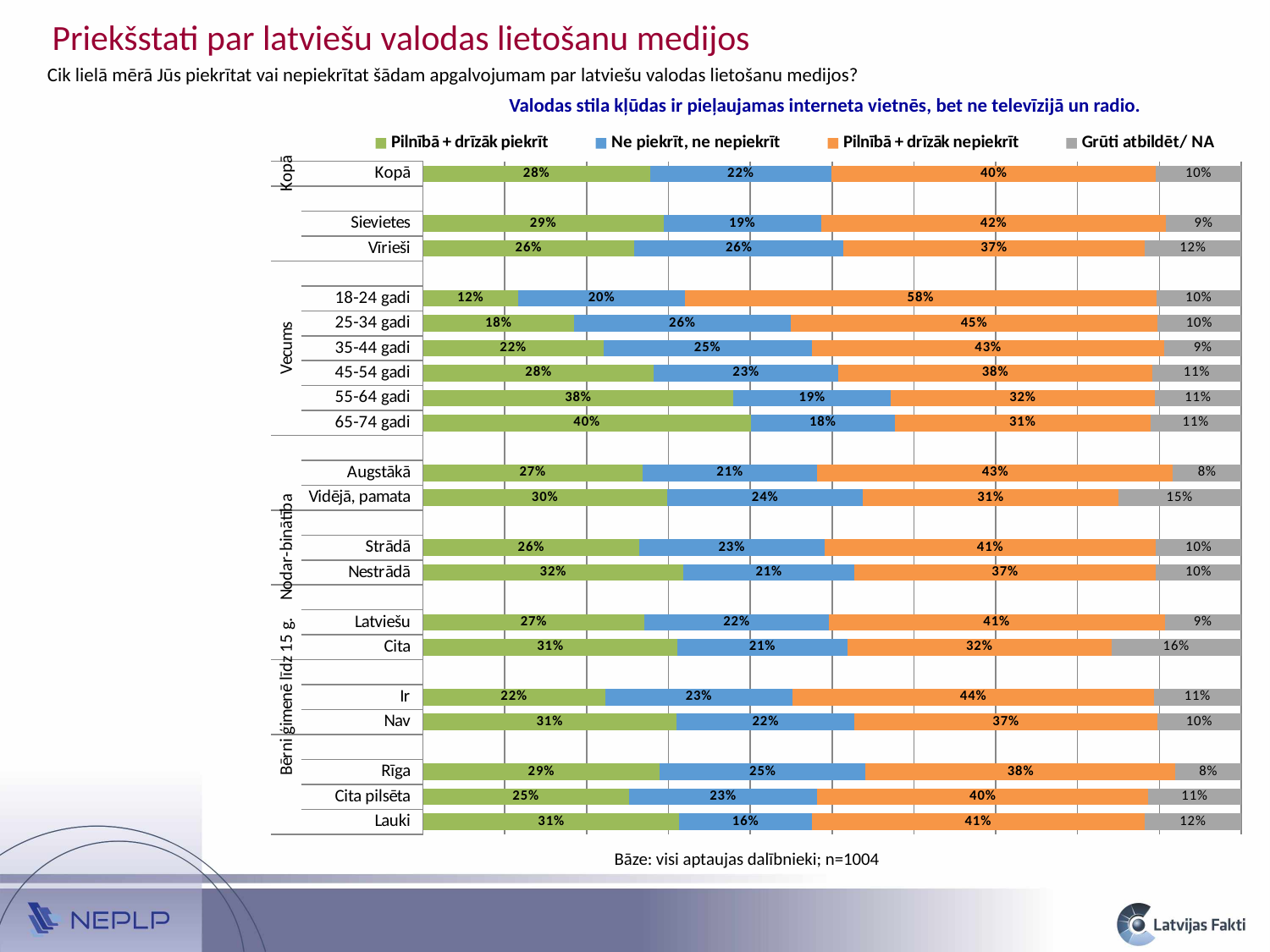
What is the value of 'Grūti atbildēt/ NA' for Vidējā, pamata? 15% Which is larger: the 'Ne piekrīt, ne nepiekrīt' value for Rīga or for Lauki? Rīga What is the value of 'Pilnībā + drīzāk piekrīt' for Kopā? 28% What type of chart is shown on the slide? Stacked bar chart Which category has the highest value for 'Pilnībā + drīzāk piekrīt'? 65-74 gadi Which category has the highest value for 'Grūti atbildēt/ NA'? Cita What is the difference between the 'Pilnībā + drīzāk nepiekrīt' values for Sievietes and Vīrieši? 5% What is the value of 'Ne piekrīt, ne nepiekrīt' for Vīrieši? 26% Which category has the lowest value for 'Pilnībā + drīzāk piekrīt'? 18-24 gadi How many categories (bars) are plotted in the chart? 20 How many series does the legend list? 4 What is the value of 'Pilnībā + drīzāk nepiekrīt' for the 18-24 gadi group? 58%